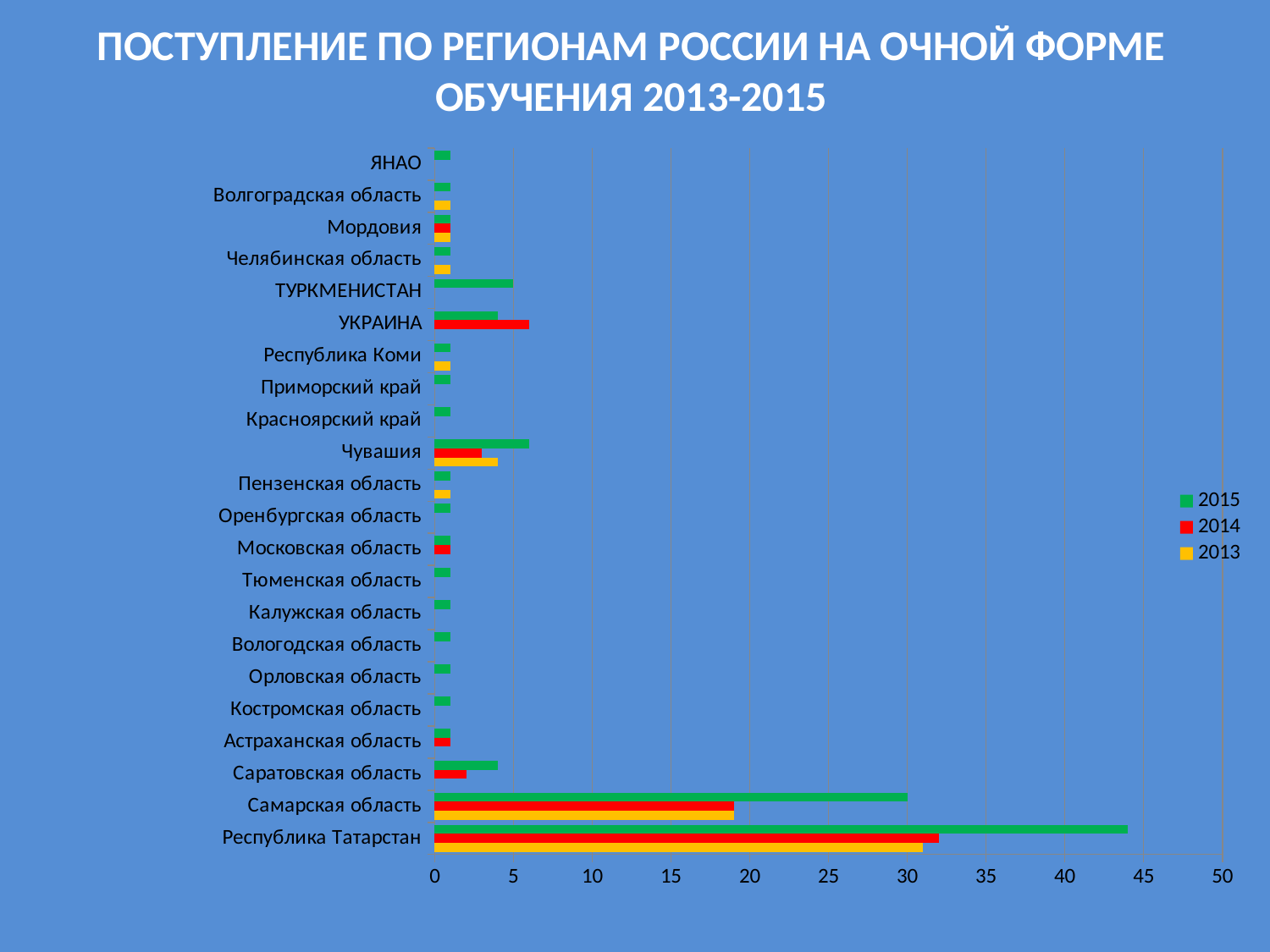
Is the 2014 value for Республика Татарстан greater or less than 30? greater Which is larger for УКРАИНА: the 2014 value or the 2015 value? 2014 Which region has the highest value for 2015? Республика Татарстан Which colour represents the 2013 series? yellow Which years are listed in the legend? 2015, 2014, 2013 Is the 2015 value for Республика Татарстан greater or less than 40? greater Which is larger for Самарская область: the 2015 value or the 2014 value? 2015 Is the 2015 value for Самарская область greater or less than 35? less How many series does the legend list? 3 What kind of chart is shown on the slide? bar chart How many regions (categories) are shown on the chart? 22